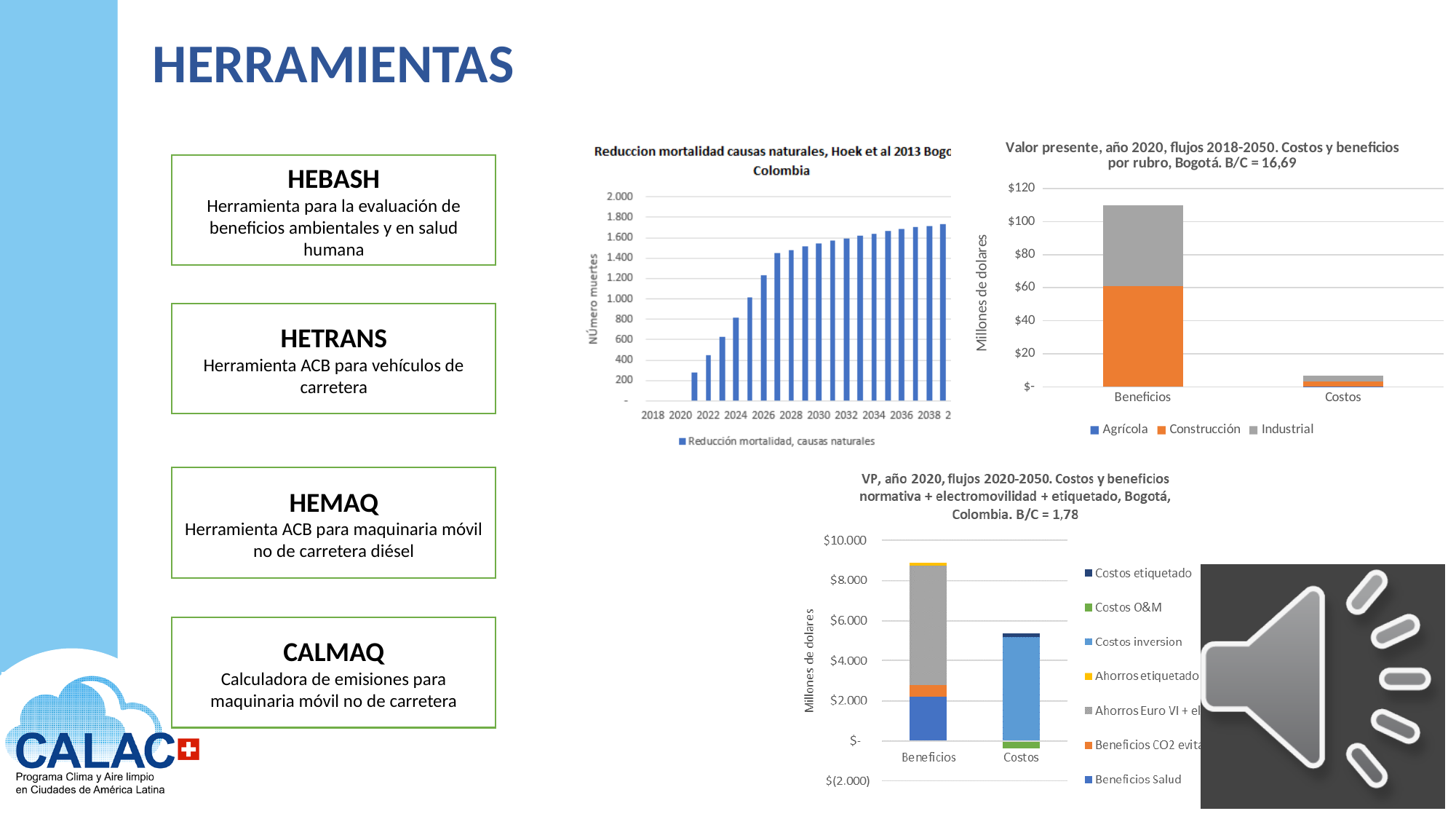
In the top-right chart 'Valor presente, año 2020, flujos 2018-2050', is the total for Costos greater or less than $20? less What kind of chart is the top-middle chart titled 'Reduccion mortalidad causas naturales'? bar chart In the top-middle chart 'Reduccion mortalidad causas naturales', is the value for 2022 greater or less than 600? less In the top-middle chart 'Reduccion mortalidad causas naturales', do the values rise or fall as the years increase along the x axis? rise In the top-middle chart 'Reduccion mortalidad causas naturales', is the value for 2030 greater or less than 1.400? greater How many categories are shown on the x axis of the bottom chart 'VP, año 2020, flujos 2020-2050'? 2 In the top-right chart 'Valor presente, año 2020, flujos 2018-2050', which category has the taller bar, Beneficios or Costos? Beneficios How many series does the legend of the top-right chart 'Valor presente, año 2020, flujos 2018-2050' list? 3 How many series does the legend of the bottom chart 'VP, año 2020, flujos 2020-2050' list? 7 What B/C value is given in the title of the top-right chart 'Valor presente, año 2020, flujos 2018-2050'? 16,69